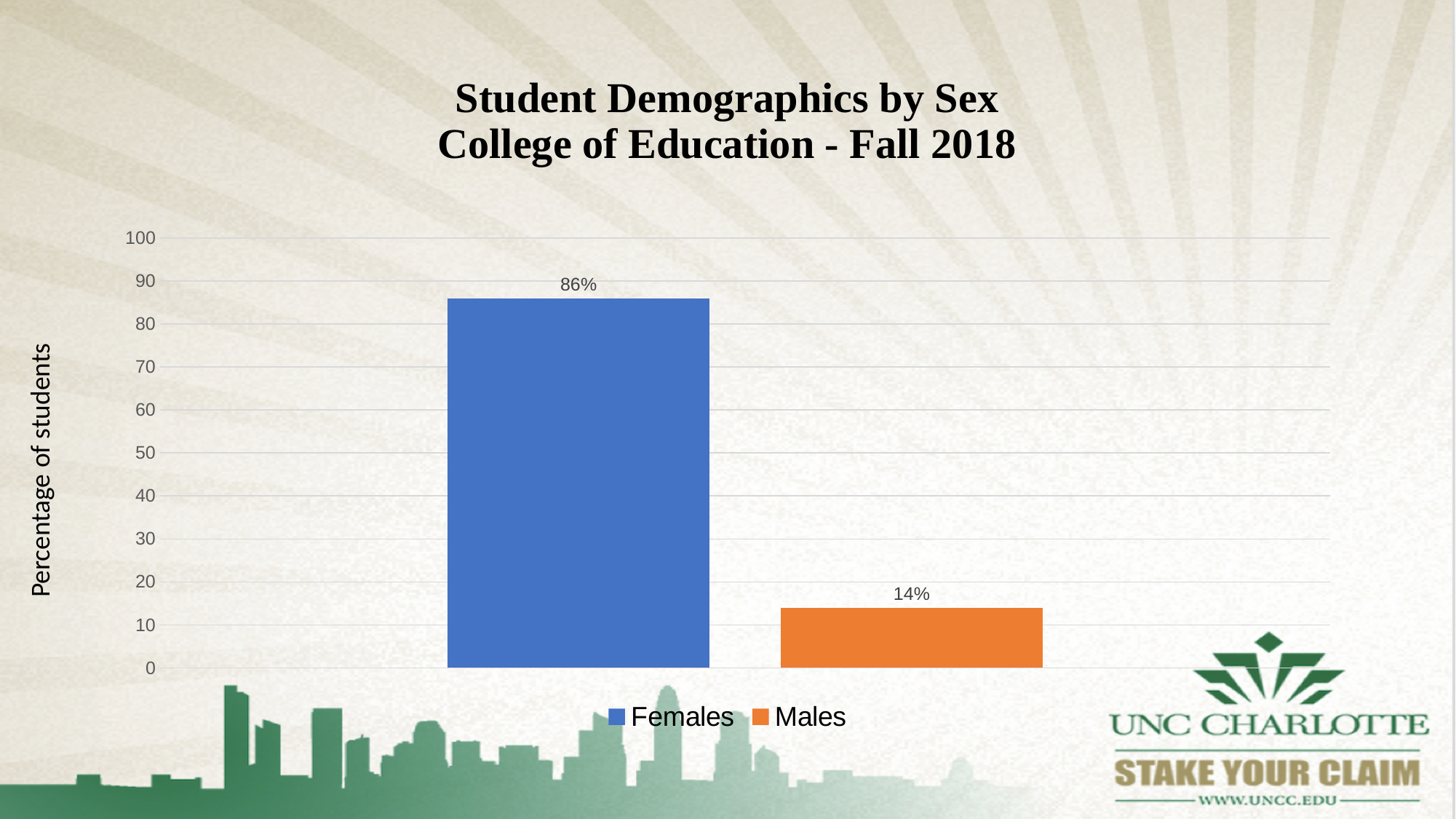
Which group has the lower percentage of students? Males How many groups are plotted in the chart? 2 What percentage of students are Males? 14% Which group has the higher percentage of students? Females What is the difference in percentage points between Females and Males? 72 Is the value for Females greater or less than 80? greater How many entries does the legend list? 2 What kind of chart is shown on the slide? Bar chart Is the value for Males greater or less than 20? less What is the label on the vertical axis? Percentage of students What is the title of the chart? Student Demographics by Sex College of Education - Fall 2018 What percentage of students are Females? 86%